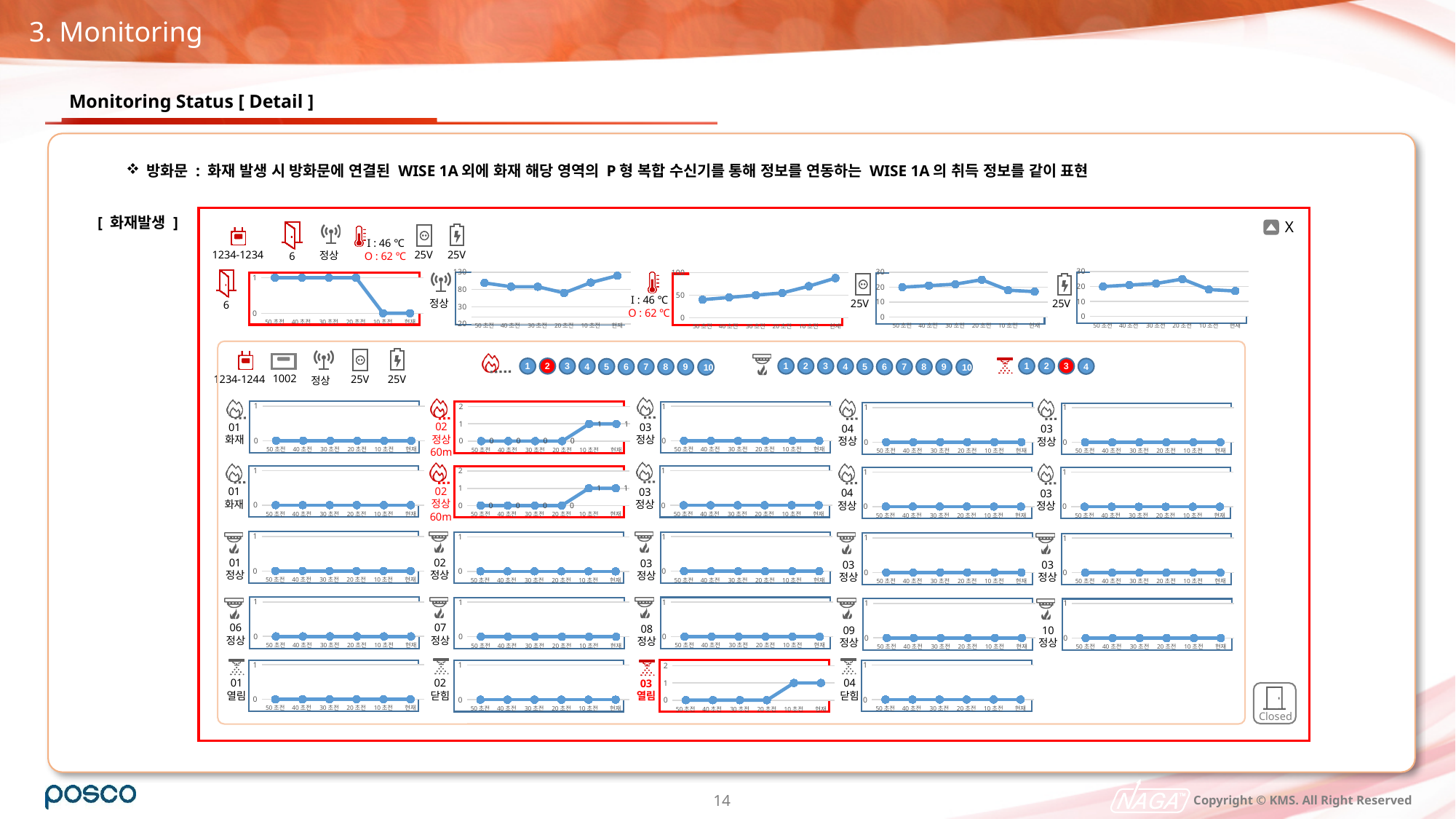
In the temperature chart (I : 46 ℃ / O : 62 ℃) in the top row, is the value at 현재 greater or less than 50? greater In the red-outlined 02 정상 60m chart in the first row of the grid, what is the value at 50 초전? 0 In the signal chart (정상) in the top row, is the value at 현재 greater or less than 80? greater In the red-outlined 02 정상 60m chart in the first row of the grid, what is the value at 현재? 1 In the temperature chart (I : 46 ℃ / O : 62 ℃) in the top row, do the values rise or fall from 50 초전 to 현재? Rise In the door chart (labelled 6) in the top row, do the values rise or fall from 50 초전 to 현재? Fall In the red-outlined 03 열림 sprinkler chart in the bottom row of the grid, what is the value at 현재? 1 In the door chart (labelled 6) in the top row, what is the value at 현재? 0 What is the label of the last point on the x axis of the charts? 현재 In the door chart (labelled 6) in the top row, what is the value at 50 초전? 1 What kind of charts are shown in the monitoring panel? Line charts How many time points are plotted along the x axis of each chart (from 50 초전 to 현재)? 6